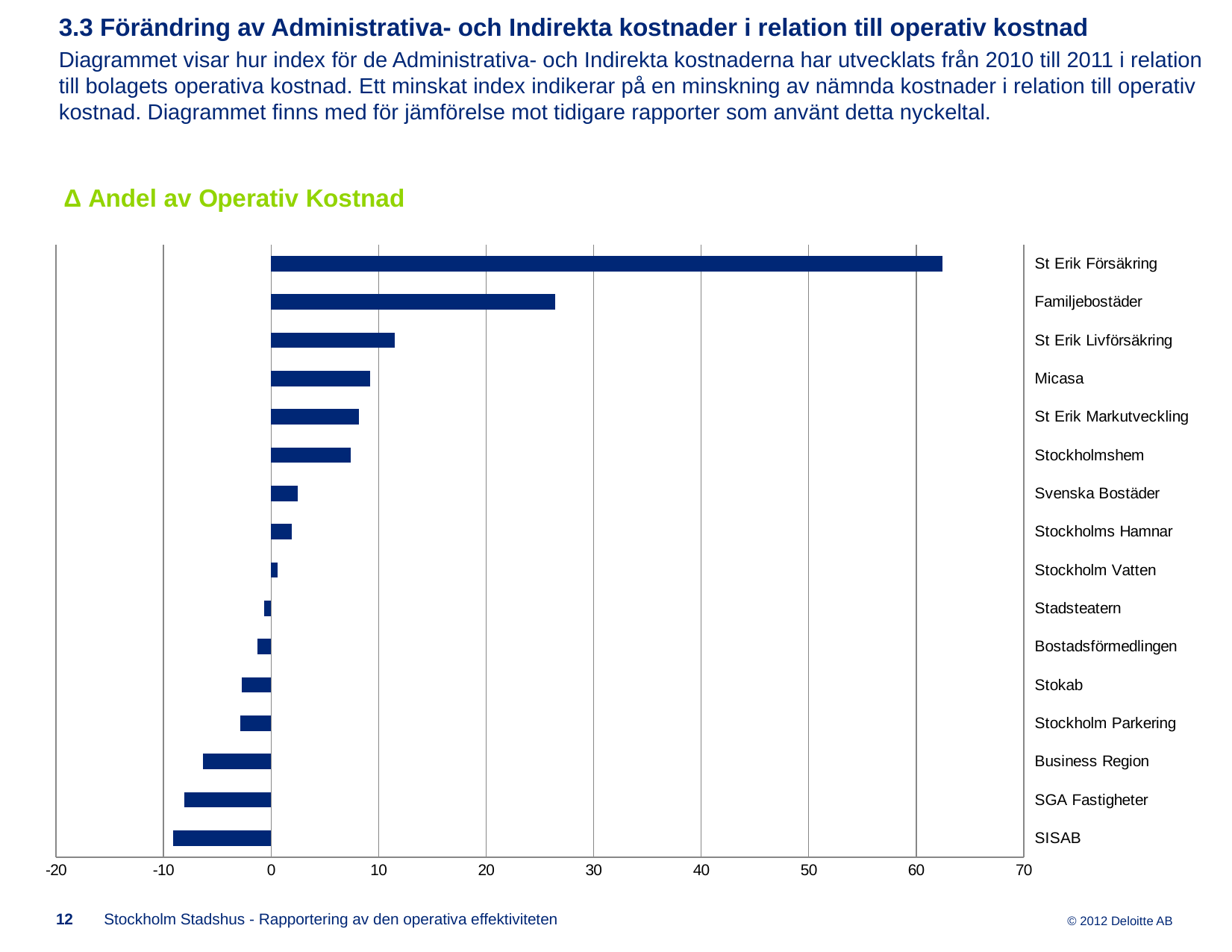
What is the title of the chart? Δ Andel av Operativ Kostnad Which company has the lowest value in the chart? SISAB Is the value for Familjebostäder greater or less than 30? less What kind of chart is shown on the slide? bar chart Which has the larger value, Familjebostäder or Micasa? Familjebostäder Is the value for St Erik Försäkring greater or less than 60? greater How many companies (categories) are shown in the chart? 16 Is the value for SISAB greater or less than -10? greater Which company has the highest value in the chart? St Erik Försäkring Which has the larger value, SGA Fastigheter or Stokab? Stokab